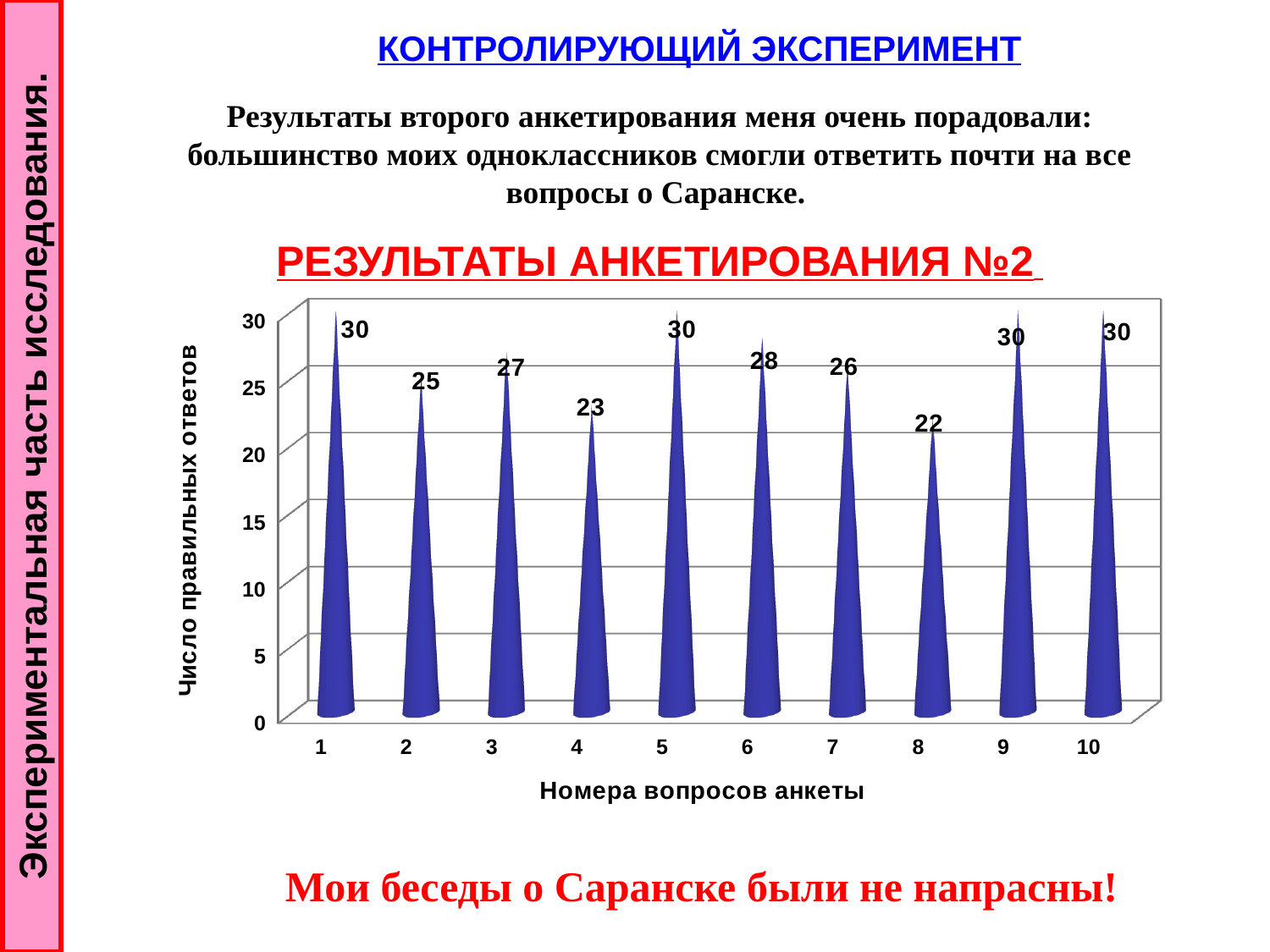
Which question number has the lowest number of correct answers? 8 What kind of chart is shown on the slide? bar chart What is the number of correct answers for question 6? 28 What is the title of the chart? РЕЗУЛЬТАТЫ АНКЕТИРОВАНИЯ №2 How many questions have a value of 30? 4 What is the difference between the values for question 3 and question 4? 4 What is the highest value shown in the chart? 30 What is the number of correct answers for question 8? 22 Which has a larger value, question 2 or question 7? question 7 What is the number of correct answers for question 4? 23 How many question numbers are shown on the x axis? 10 Is the value for question 8 greater or less than 25? less